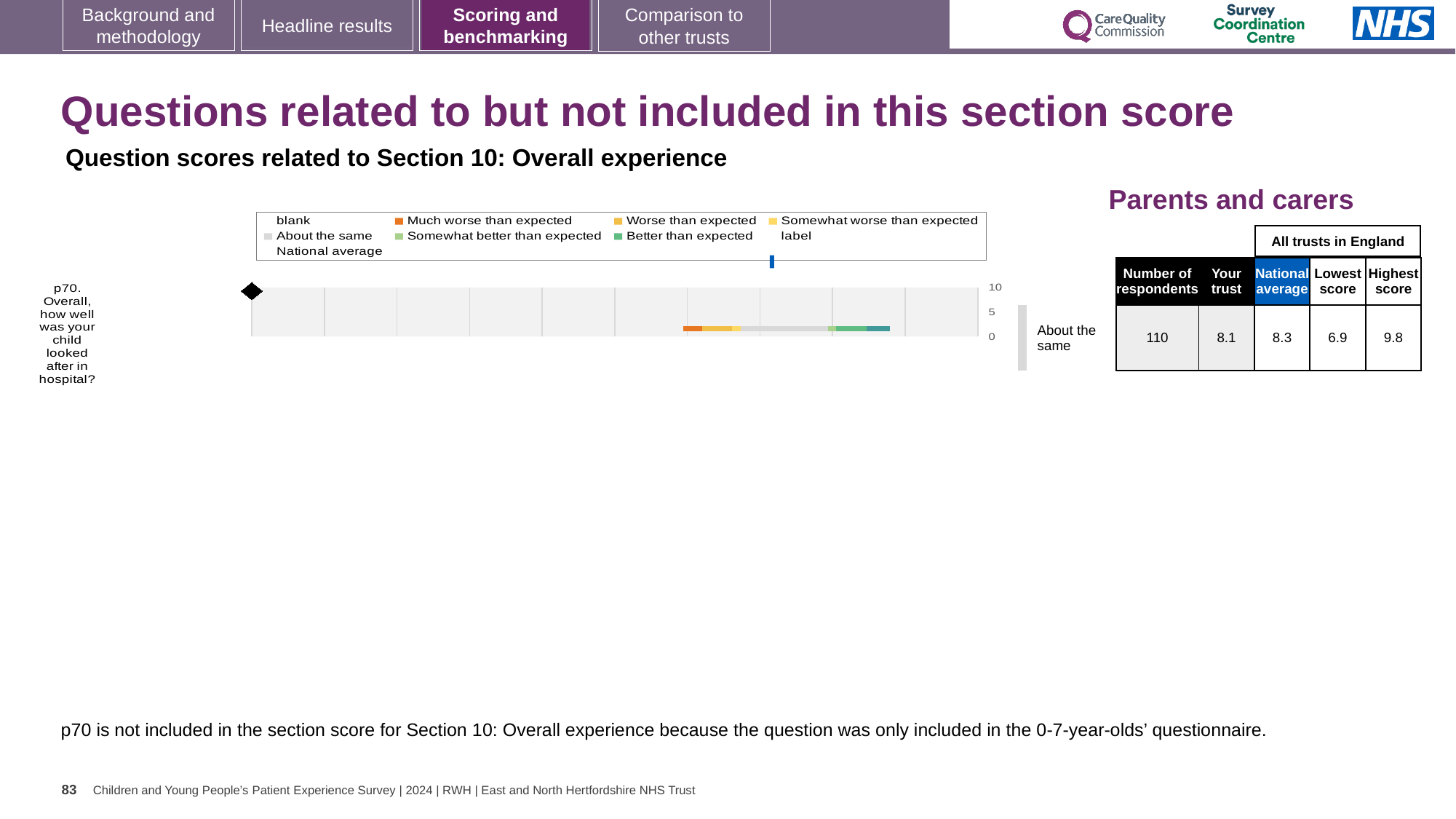
What is the 'Your trust' score for p70? 8.1 What is the highest score among all trusts in England for p70? 9.8 What is the difference between the highest and lowest scores for p70? 2.9 Which question is plotted in the chart? p70. Overall, how well was your child looked after in hospital? How many questions are plotted in the chart? 1 What comparison category is shown next to the bar for p70? About the same How many entries does the chart legend list? 9 How many respondents answered p70? 110 What is the national average score for p70? 8.3 What is the lowest score among all trusts in England for p70? 6.9 What kind of chart is used to show the p70 question score? bar chart Which is larger for p70, the 'Your trust' score or the national average? National average